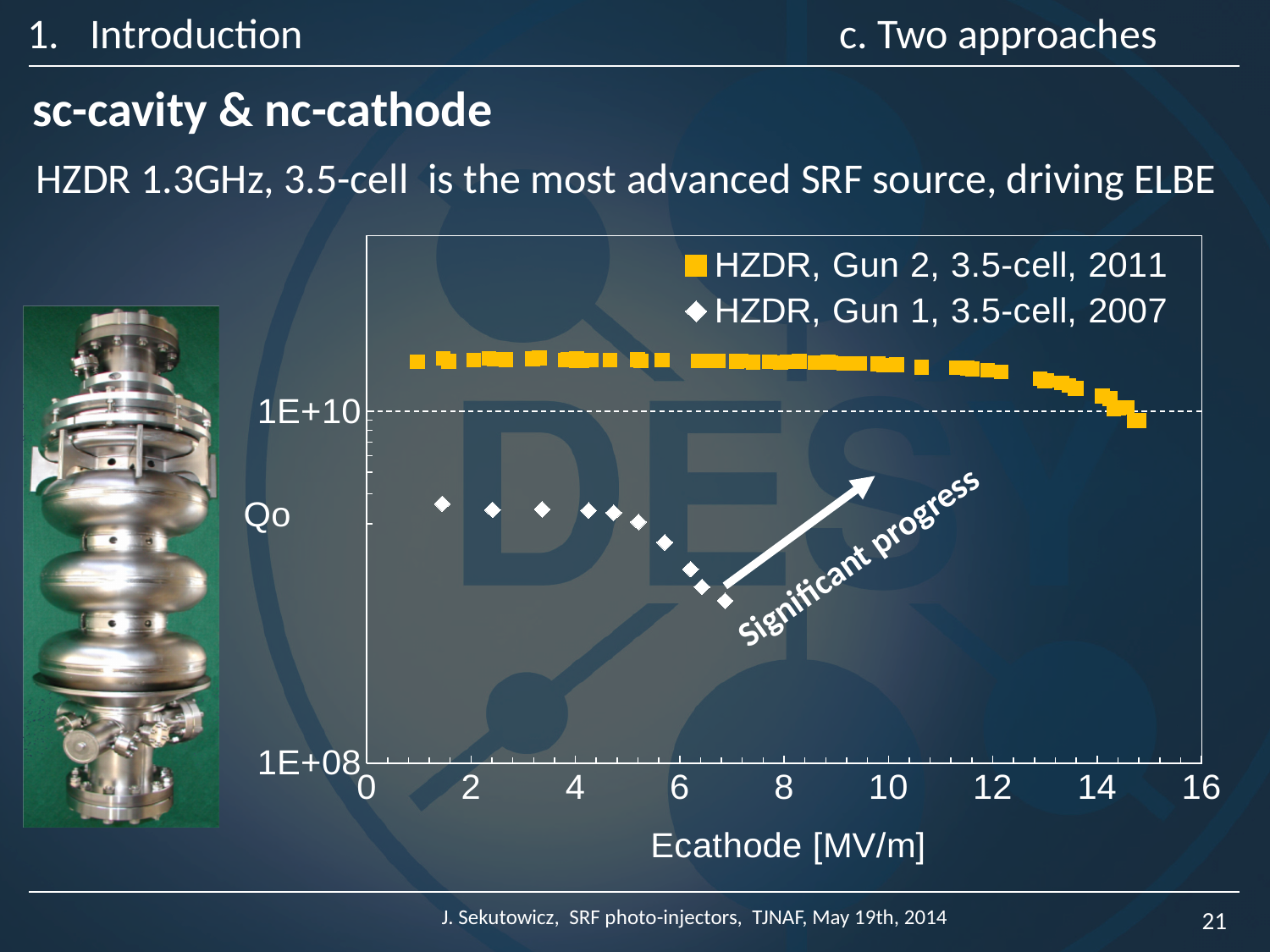
How many series does the chart legend list? 2 What is the label of the x axis of the chart? Ecathode [MV/m] Do the Qo values for HZDR Gun 2 (2011) rise or fall as Ecathode increases beyond about 12 MV/m? fall Is the Qo value for HZDR Gun 1 (2007) at Ecathode of about 2 MV/m greater or less than 1E+10? less Is the Qo value for HZDR Gun 2 (2011) at Ecathode of 8 MV/m greater or less than 1E+10? greater Do the Qo values for HZDR Gun 1 (2007) rise or fall as Ecathode increases? fall What is the lowest tick value labelled on the y axis of the chart? 1E+08 What is the highest tick value shown on the x axis of the chart? 16 Which series has the higher Qo values, HZDR Gun 2 (2011) or HZDR Gun 1 (2007)? HZDR, Gun 2, 3.5-cell, 2011 Which series is plotted with orange square markers? HZDR, Gun 2, 3.5-cell, 2011 What kind of chart is shown on the slide? Scatter chart Is the Qo value for HZDR Gun 1 (2007) at Ecathode of about 6 MV/m greater or less than 1E+08? greater